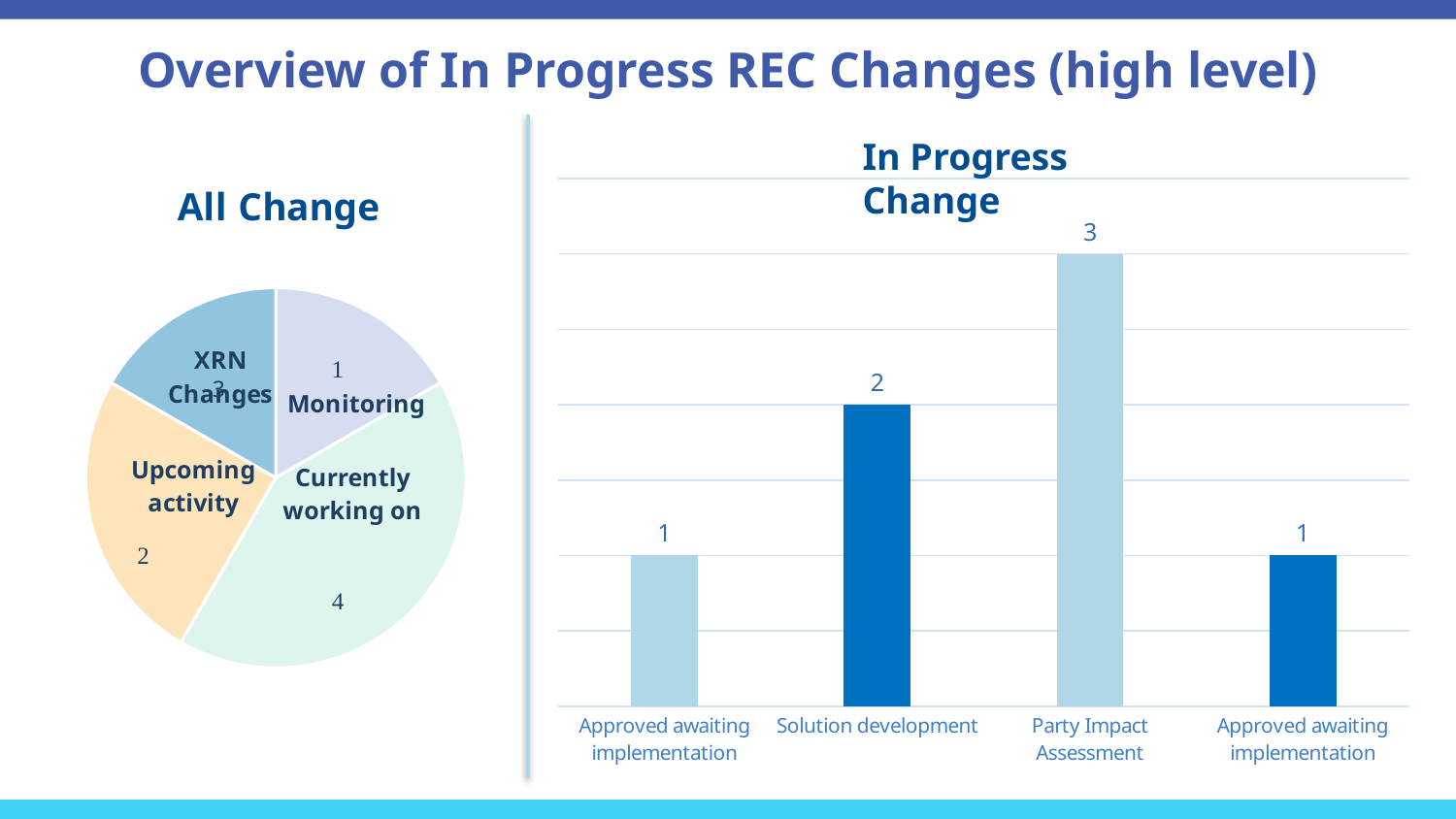
In the 'All Change' pie chart, which slice is the smallest? Monitoring In the 'In Progress Change' chart, which category has the highest value? Party Impact Assessment In the 'In Progress Change' chart, what is the value for 'Party Impact Assessment'? 3 In the 'In Progress Change' chart, what is the difference between 'Party Impact Assessment' and 'Solution development'? 1 In the 'All Change' pie chart, what is the value of the 'Monitoring' slice? 1 In the 'All Change' pie chart, which slice is the largest? Currently working on In the 'All Change' pie chart, how many changes are in the 'Currently working on' slice? 4 In the 'In Progress Change' chart, how many bars are plotted? 4 In the 'All Change' pie chart, what is the difference between 'Currently working on' and 'Upcoming activity'? 2 In the 'All Change' pie chart, how many slices are there? 4 In the 'In Progress Change' chart, what is the value for 'Solution development'? 2 What type of chart is the 'In Progress Change' chart? Bar chart